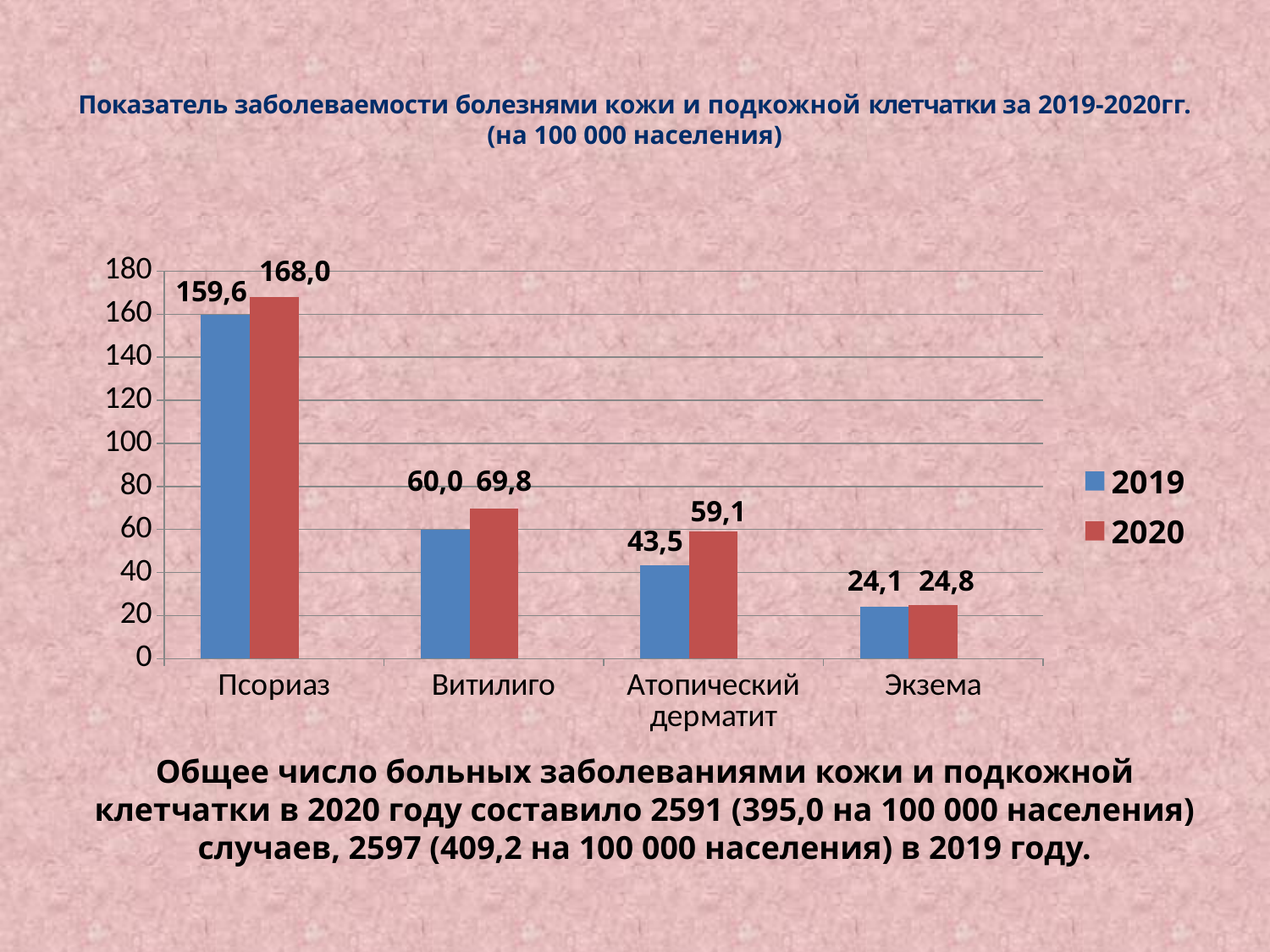
How many categories are shown on the x axis? 4 What is the difference between the 2020 and 2019 values for Атопический дерматит? 15,6 What is the difference between the 2020 and 2019 values for Псориаз? 8,4 What is the 2019 value for Псориаз? 159,6 What kind of chart is shown on the slide? Bar chart What is the 2020 value for Атопический дерматит? 59,1 Which category has the highest 2020 value? Псориаз What is the 2019 value for Экзема? 24,1 What is the 2020 value for Витилиго? 69,8 Which category has the lowest 2019 value? Экзема How many series does the legend list? 2 Which is larger for Витилиго, the 2019 value or the 2020 value? 2020